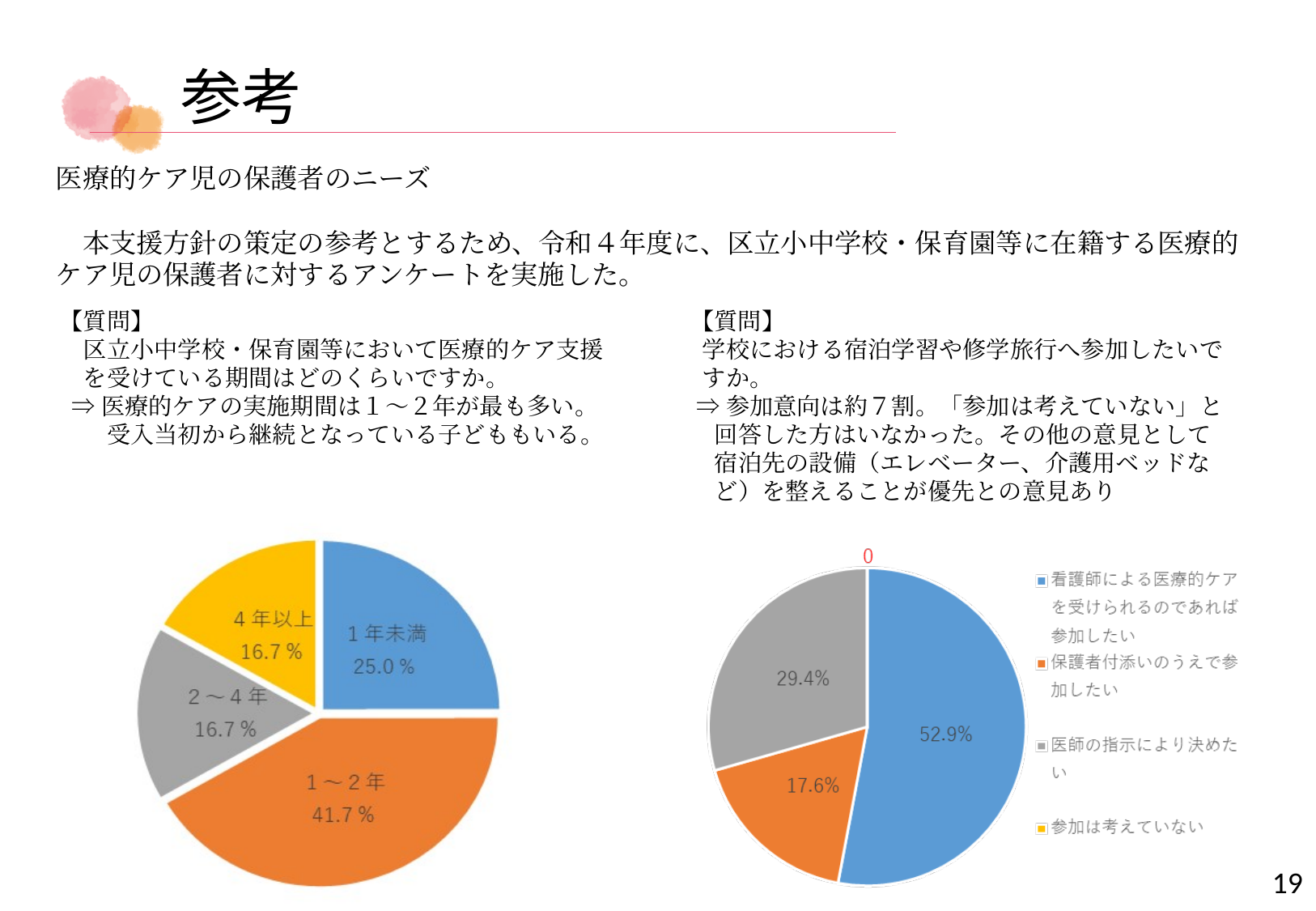
In the left pie chart, what percentage is shown for 1～2年? 41.7 % How many entries does the legend of the right pie chart list? 4 In the left pie chart, which is larger: the share for 1年未満 or the share for 2～4年? 1年未満 In the right pie chart, what percentage is shown for 保護者付添いのうえで参加したい? 17.6% In the right pie chart, what percentage is shown for 医師の指示により決めたい? 29.4% In the left pie chart, what is the difference between the shares of 1～2年 and 1年未満? 16.7 % What type of chart is the chart on the left of the slide? Pie chart In the right pie chart, which category has the largest share? 看護師による医療的ケアを受けられるのであれば参加したい In the left pie chart, how many categories are shown? 4 In the left pie chart, what percentage is shown for 1年未満? 25.0 % In the right pie chart, what value is shown for 参加は考えていない? 0 In the left pie chart, which category has the largest share? 1～2年